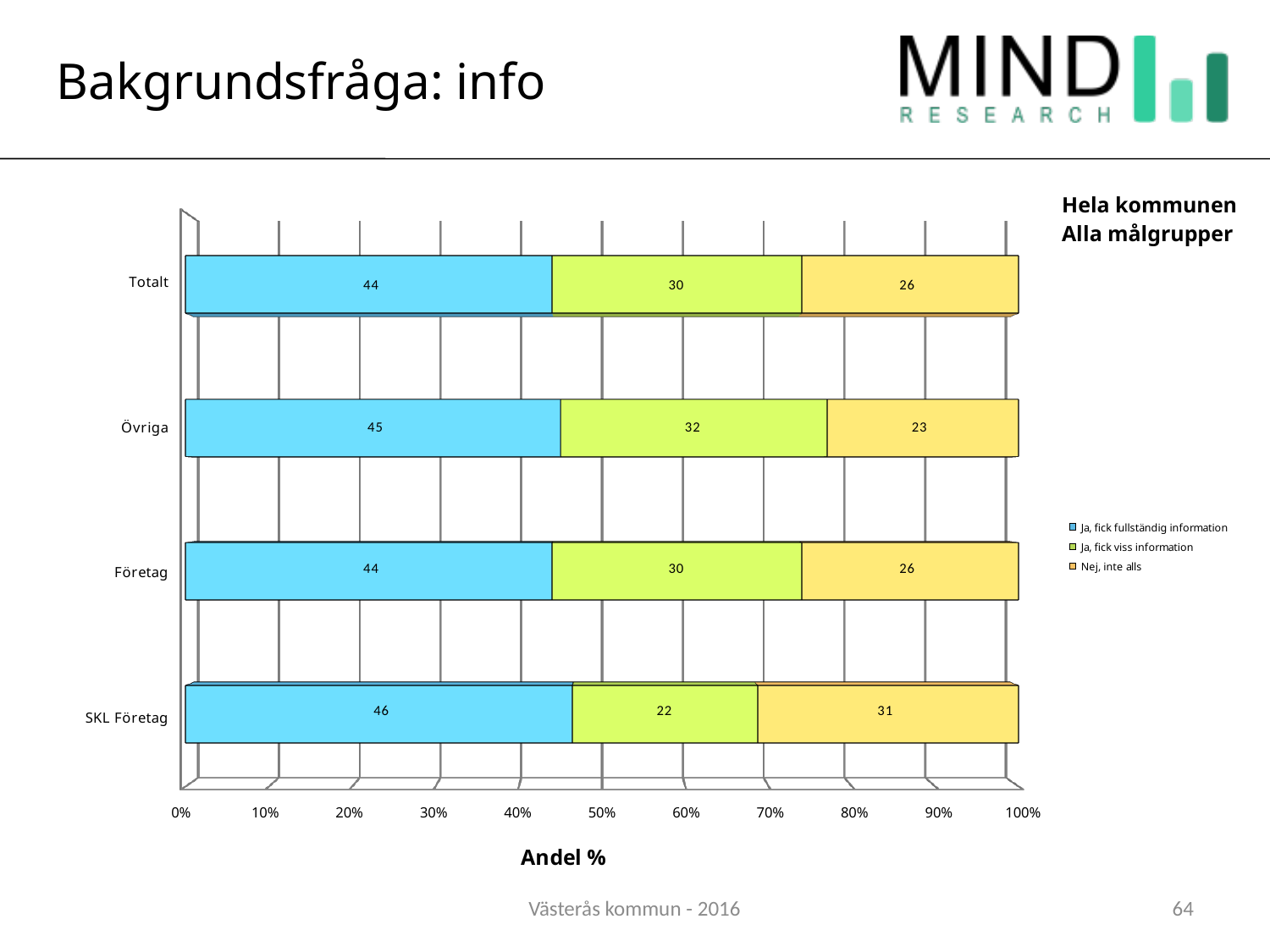
Which category has the lowest value for 'Ja, fick viss information'? SKL Företag What is the difference between the 'Nej, inte alls' values for SKL Företag and Övriga? 8 What is the text shown in the top-right corner above the legend? Hela kommunen Alla målgrupper What is the value of 'Ja, fick viss information' for Övriga? 32 What is the value of 'Nej, inte alls' for SKL Företag? 31 What is the value of 'Ja, fick fullständig information' for Totalt? 44 How many series does the legend list? 3 Which is larger: the 'Ja, fick viss information' value for Övriga or for Företag? Övriga How many categories are shown on the vertical axis of the chart? 4 What is the label of the horizontal axis? Andel % Which category has the highest value for 'Ja, fick fullständig information'? SKL Företag What kind of chart is shown on the slide? stacked bar chart